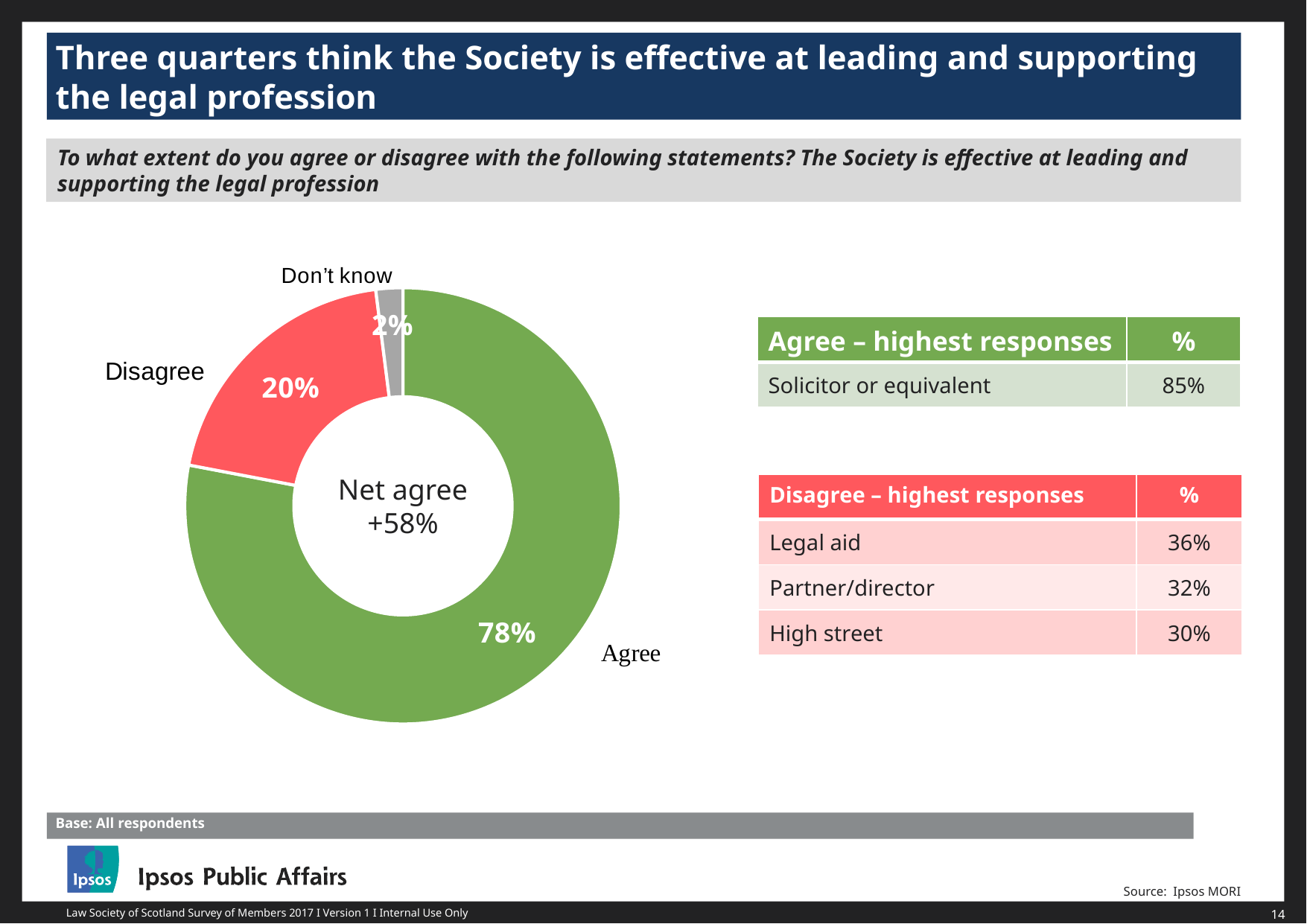
How many response categories are shown in the donut chart? 3 Which response category has the largest share of the donut chart? Agree What percentage of respondents disagree? 20% Which response category has the smallest share of the donut chart? Don't know Which is larger, the share for Disagree or the share for Don't know? Disagree What percentage of respondents agree that the Society is effective at leading and supporting the legal profession? 78% What is the difference in percentage points between Agree and Disagree? 58 What is the combined share of Disagree and Don't know? 22% What net agree figure is shown in the centre of the donut chart? +58% What colour is the Agree segment of the donut chart? Green What percentage of respondents answered 'Don't know'? 2% What kind of chart is used to show the agree/disagree responses? Donut (pie) chart